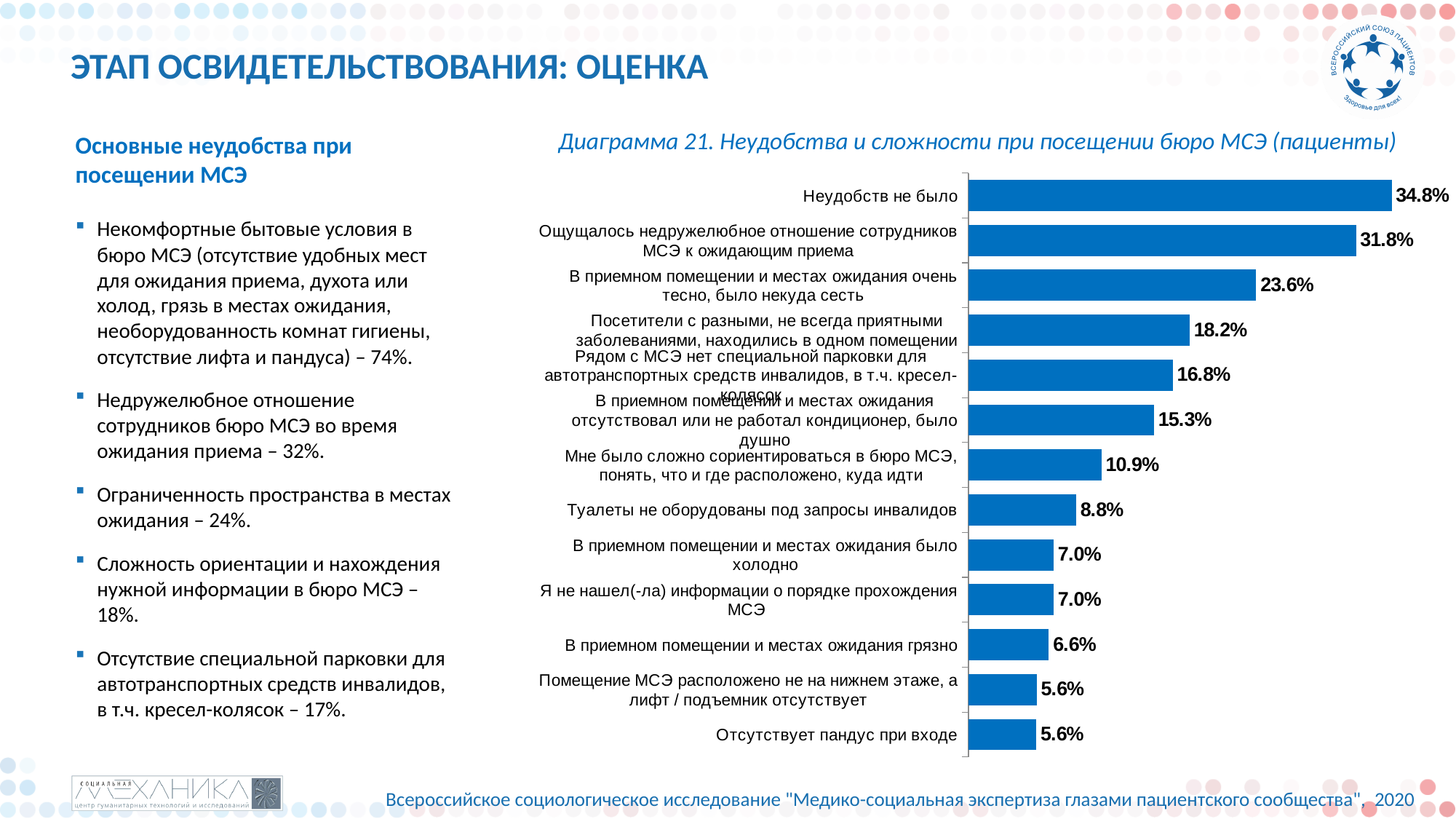
What is the difference between the values for "Рядом с МСЭ нет специальной парковки для автотранспортных средств инвалидов, в т.ч. кресел-колясок" and "Отсутствует пандус при входе"? 11.2% What type of chart is shown on the slide? Bar chart What is the value for "Неудобств не было"? 34.8% What is the title of the chart? Диаграмма 21. Неудобства и сложности при посещении бюро МСЭ (пациенты) Which is larger: the value for "В приемном помещении и местах ожидания очень тесно, было некуда сесть" or for "Посетители с разными, не всегда приятными заболеваниями, находились в одном помещении"? В приемном помещении и местах ожидания очень тесно, было некуда сесть Which category has the highest value? Неудобств не было Do the values rise or fall going from the top bar to the bottom bar? Fall What is the value for "Туалеты не оборудованы под запросы инвалидов"? 8.8% What is the value for "В приемном помещении и местах ожидания грязно"? 6.6% What is the value for "Мне было сложно сориентироваться в бюро МСЭ, понять, что и где расположено, куда идти"? 10.9% How many categories are plotted in the chart? 13 What is the difference between the values for "Неудобств не было" and "Ощущалось недружелюбное отношение сотрудников МСЭ к ожидающим приема"? 3.0%